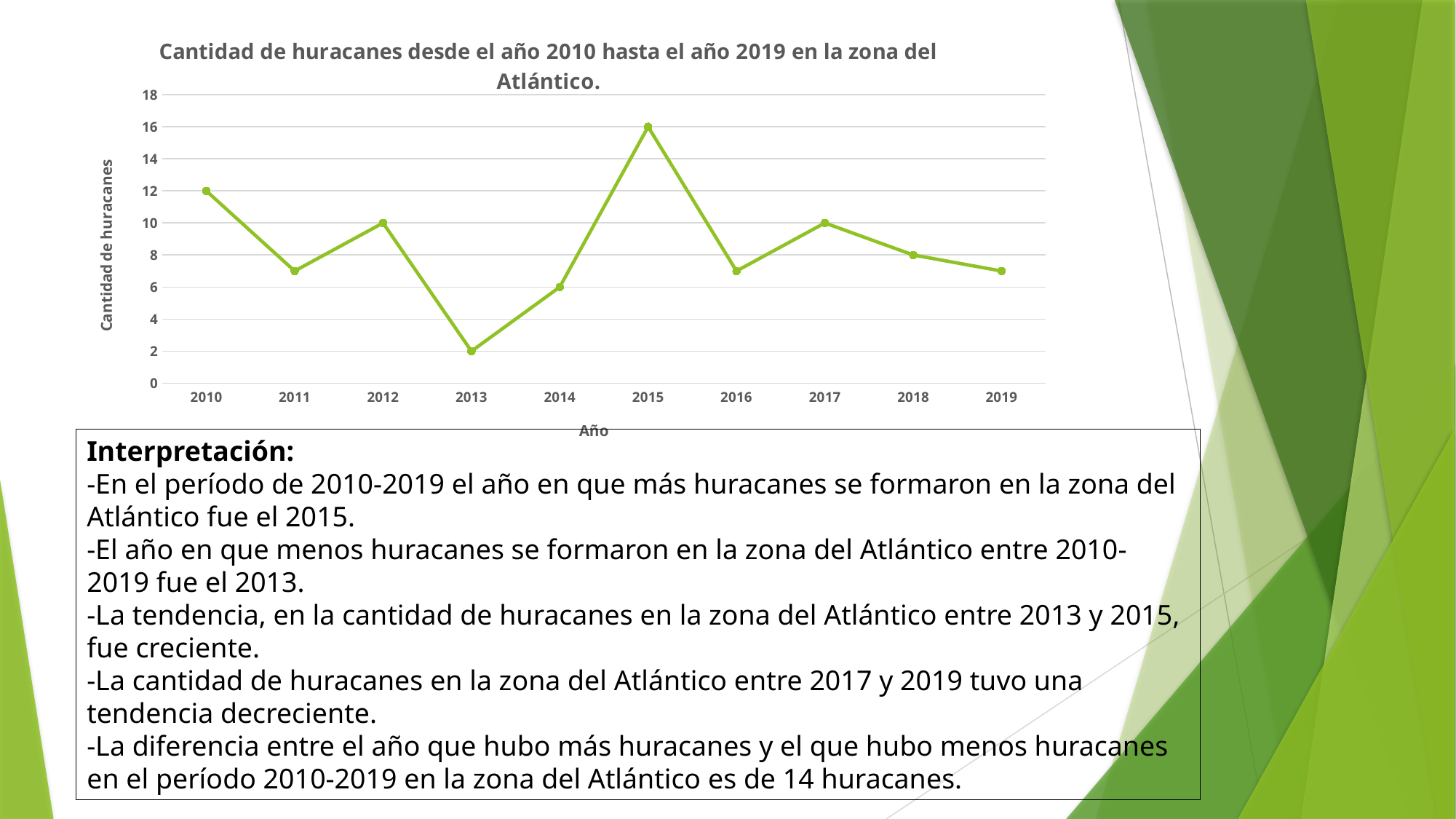
How many hurricanes were there in 2013? 2 Which year had the lowest number of hurricanes? 2013 Which year had the highest number of hurricanes? 2015 How many years are plotted on the x axis? 10 How many hurricanes were there in 2010? 12 Which year had more hurricanes, 2012 or 2014? 2012 How many hurricanes were there in 2018? 8 What kind of chart is shown on the slide? line chart Do the values rise or fall from 2017 to 2019? fall Is the value for 2011 greater or less than 8? less How many hurricanes were there in 2015? 16 What is the difference between the number of hurricanes in 2015 and in 2013? 14